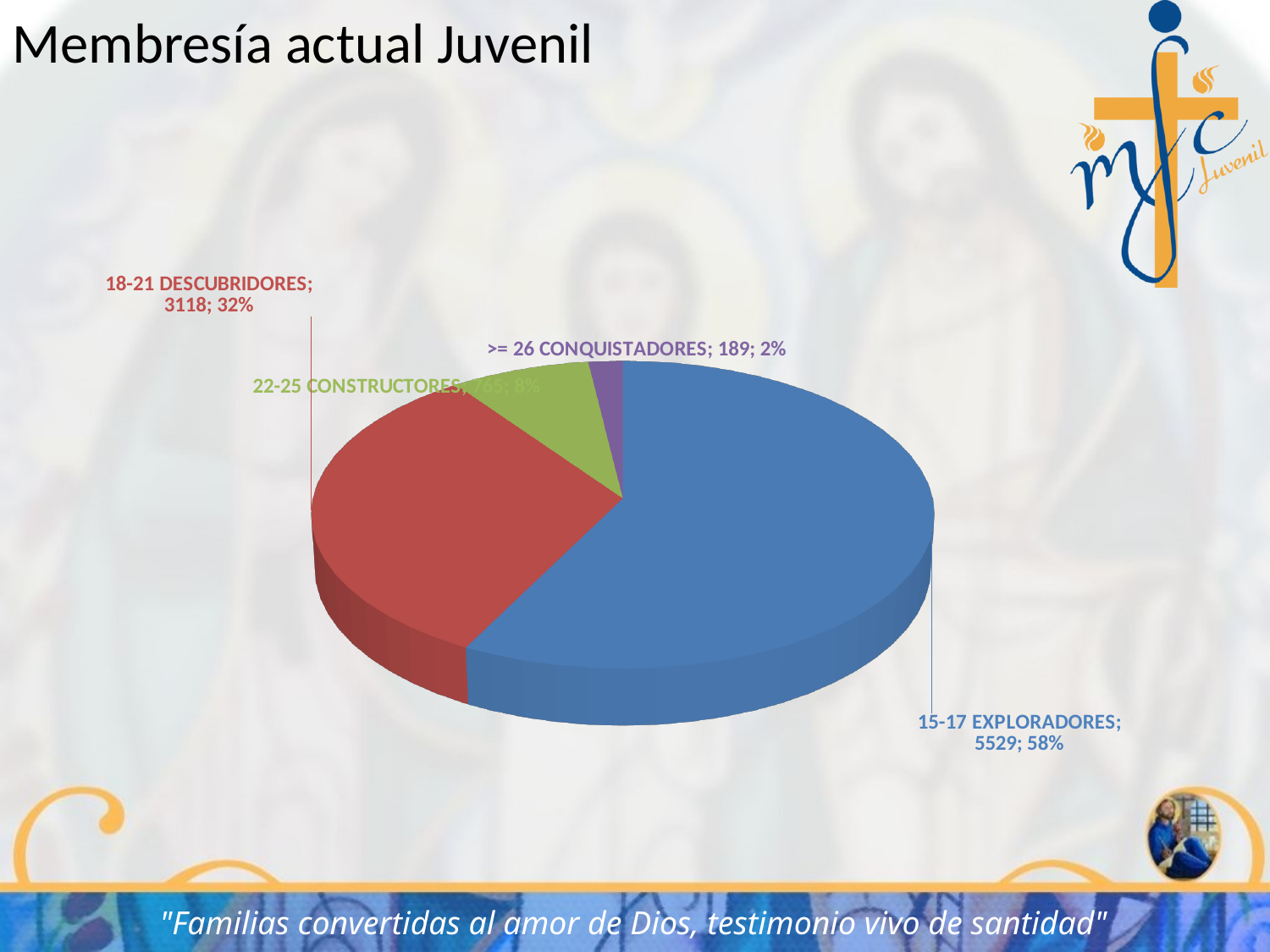
What is the value for >= 26 CONQUISTADORES? 189 How many slices does the pie chart have? 4 Which category has the largest slice of the pie? 15-17 EXPLORADORES What share of the pie does 18-21 DESCUBRIDORES represent? 32% What is the value for 15-17 EXPLORADORES? 5529 What is the value for 18-21 DESCUBRIDORES? 3118 What share of the pie does >= 26 CONQUISTADORES represent? 2% What is the title of the slide containing the pie chart? Membresía actual Juvenil What share of the pie does 15-17 EXPLORADORES represent? 58% Which category has the smallest slice of the pie? >= 26 CONQUISTADORES What is the difference between the values for 15-17 EXPLORADORES and 18-21 DESCUBRIDORES? 2411 What kind of chart is shown on the slide? pie chart